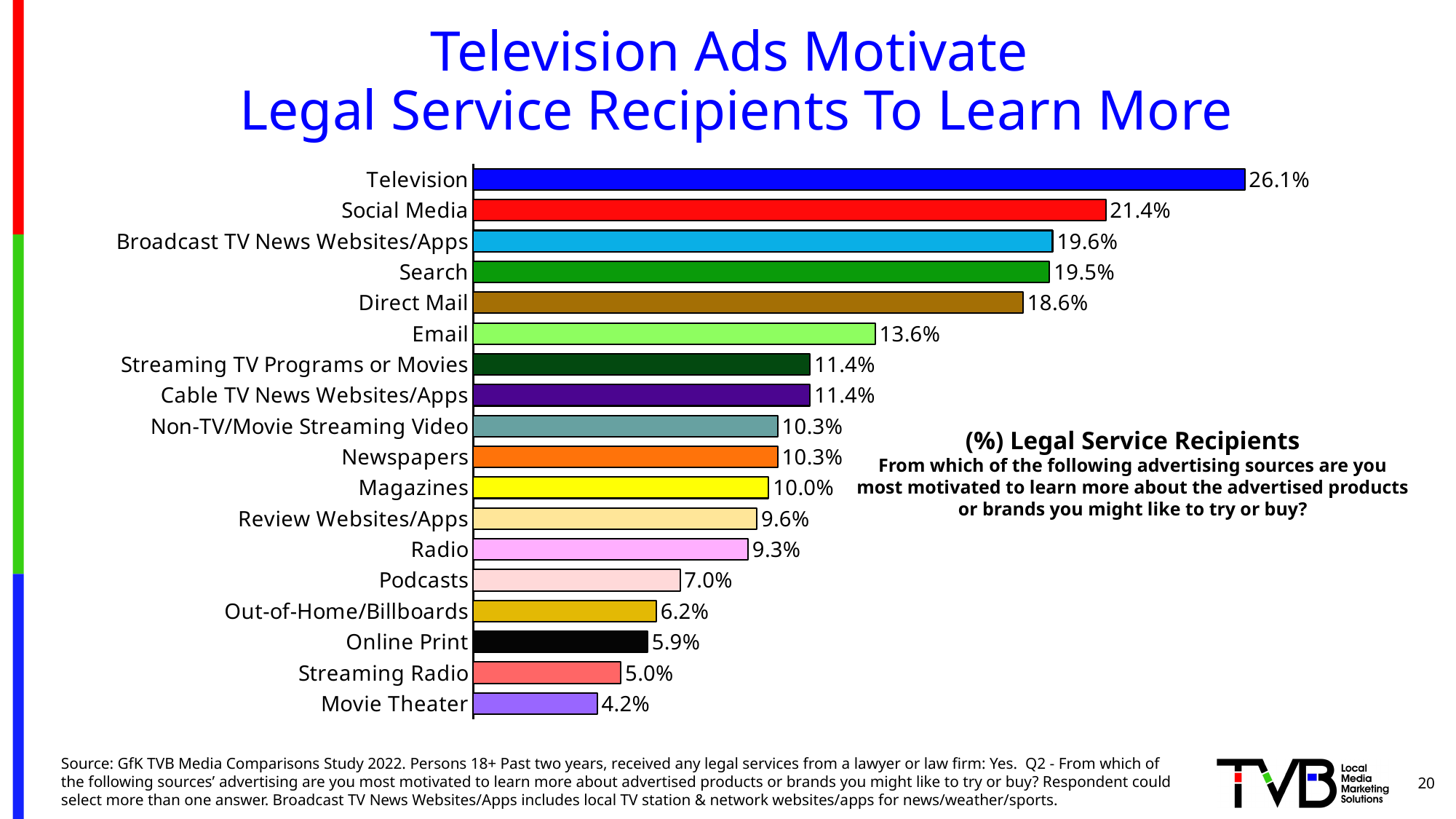
Which category has the highest value? Television What is the value for Television? 26.1% Which is larger, the value for Out-of-Home/Billboards or the value for Streaming Radio? Out-of-Home/Billboards What is the difference between the values for Television and Social Media? 4.7% How many categories are shown in the chart? 18 What is the value for Podcasts? 7.0% What is the value for Direct Mail? 18.6% What is the difference between the values for Email and Radio? 4.3% What colour is the bar for Social Media? Red What kind of chart is shown on the slide? Bar chart Which is larger, the value for Search or the value for Magazines? Search Which category has the lowest value? Movie Theater